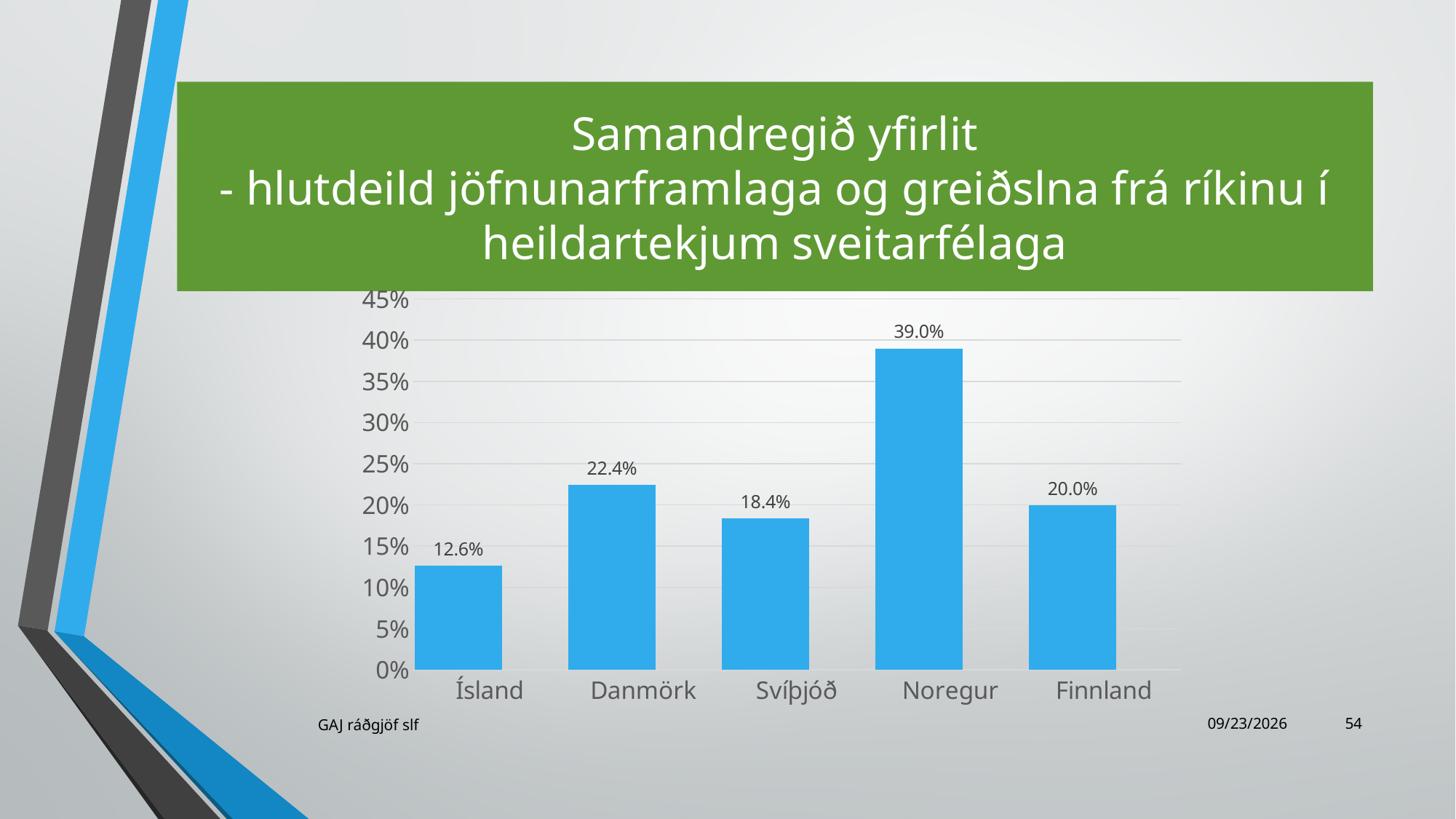
How many countries are shown on the chart? 5 What kind of chart is shown on the slide? bar chart What colour are the bars in the chart? blue What is the difference between the values for Finnland and Svíþjóð? 1.6% Is the value for Noregur greater or less than 35%? greater Which country has the highest value? Noregur Which country has the lowest value? Ísland What is the value for Ísland? 12.6% Which is larger, the value for Danmörk or the value for Svíþjóð? Danmörk What is the difference between the values for Noregur and Danmörk? 16.6% What is the value for Noregur? 39.0% What is the value for Finnland? 20.0%